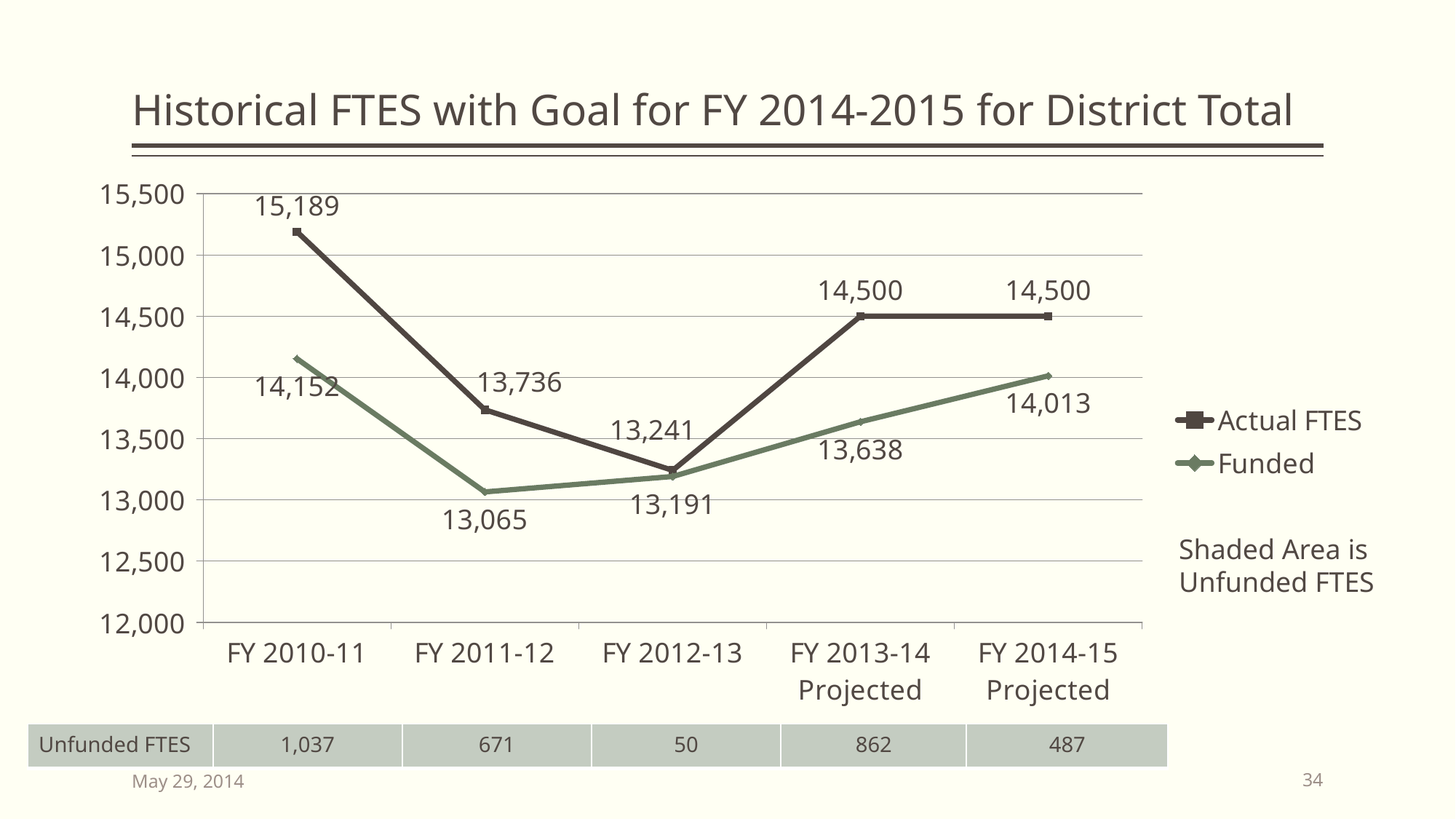
In which fiscal year is the Funded value lowest? FY 2011-12 What is the Funded value for FY 2011-12? 13,065 How many fiscal years are shown on the x axis? 5 How many series does the legend list? 2 What is the difference between Actual FTES and Funded in FY 2012-13? 50 What is the Actual FTES value for FY 2013-14 Projected? 14,500 Which is larger in FY 2013-14 Projected, Actual FTES or Funded? Actual FTES What kind of chart is shown on the slide? Line chart What is the Actual FTES value for FY 2010-11? 15,189 What is the Funded value for FY 2014-15 Projected? 14,013 In which fiscal year is the Actual FTES value highest? FY 2010-11 Does the Actual FTES line rise or fall from FY 2010-11 to FY 2012-13? Fall